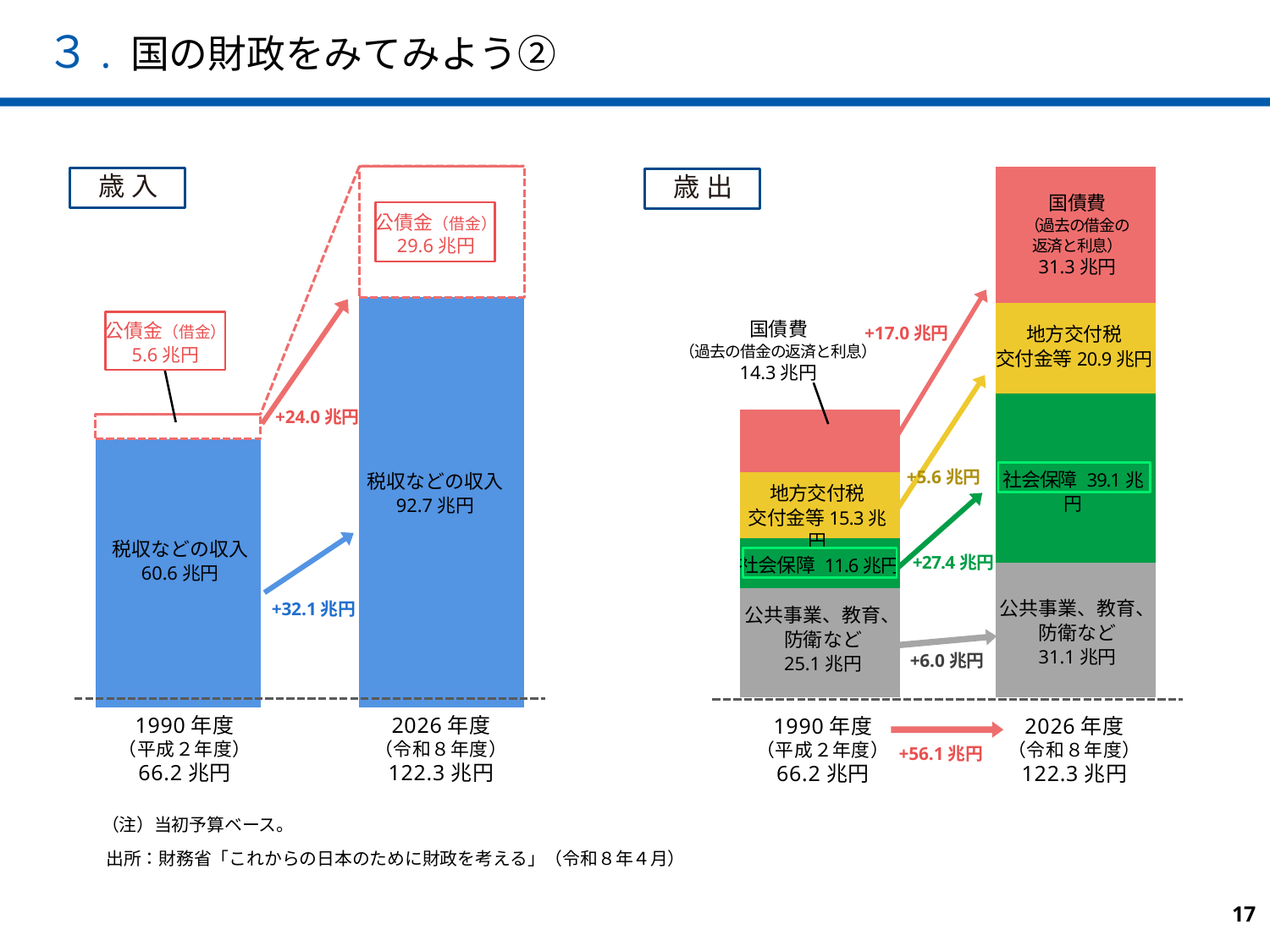
In the 歳入 chart, what is the total for 2026 年度? 122.3 兆円 In the 歳入 chart, what is the value of 税収などの収入 for 1990 年度? 60.6 兆円 In the 歳出 chart, which is larger for 2026 年度: 国債費 or 地方交付税交付金等? 国債費 In the 歳出 chart, which segment is the largest for 2026 年度? 社会保障 How many segments make up the 2026 年度 bar in the 歳出 chart? 4 What kind of chart is the 歳出 chart? Stacked bar chart In the 歳入 chart, what is the value of 公債金（借金） for 2026 年度? 29.6 兆円 In the 歳出 chart, what is the value of 国債費 for 1990 年度? 14.3 兆円 In the 歳入 chart, by how much does 税収などの収入 increase from 1990 年度 to 2026 年度? +32.1 兆円 In the 歳出 chart, what is the value of 社会保障 for 2026 年度? 39.1 兆円 In the 歳出 chart, by how much does the total increase from 1990 年度 to 2026 年度? +56.1 兆円 In the 歳出 chart, which segment is the smallest for 1990 年度? 社会保障